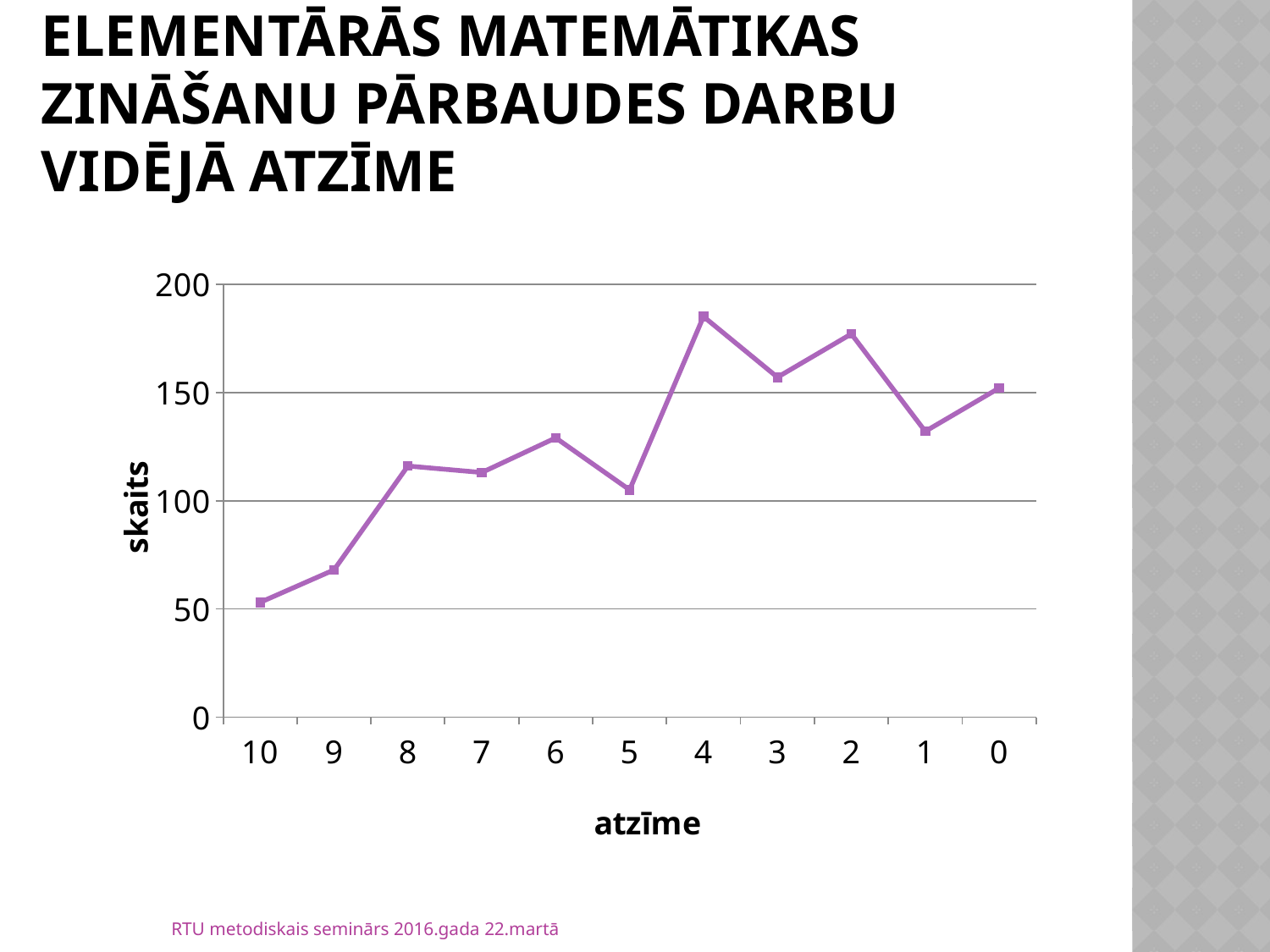
Is the value for atzīme 9 greater or less than 100? less What is the label of the vertical axis? skaits Which has a larger value, atzīme 2 or atzīme 1? 2 What is the label of the horizontal axis? atzīme Which has a larger value, atzīme 5 or atzīme 6? 6 How many data points are plotted on the line? 11 Is the value for atzīme 4 greater or less than 150? greater Is the value for atzīme 10 greater or less than 100? less Which atzīme (grade) has the lowest skaits value? 10 Which atzīme (grade) has the highest skaits value? 4 What kind of chart is shown on the slide? line chart